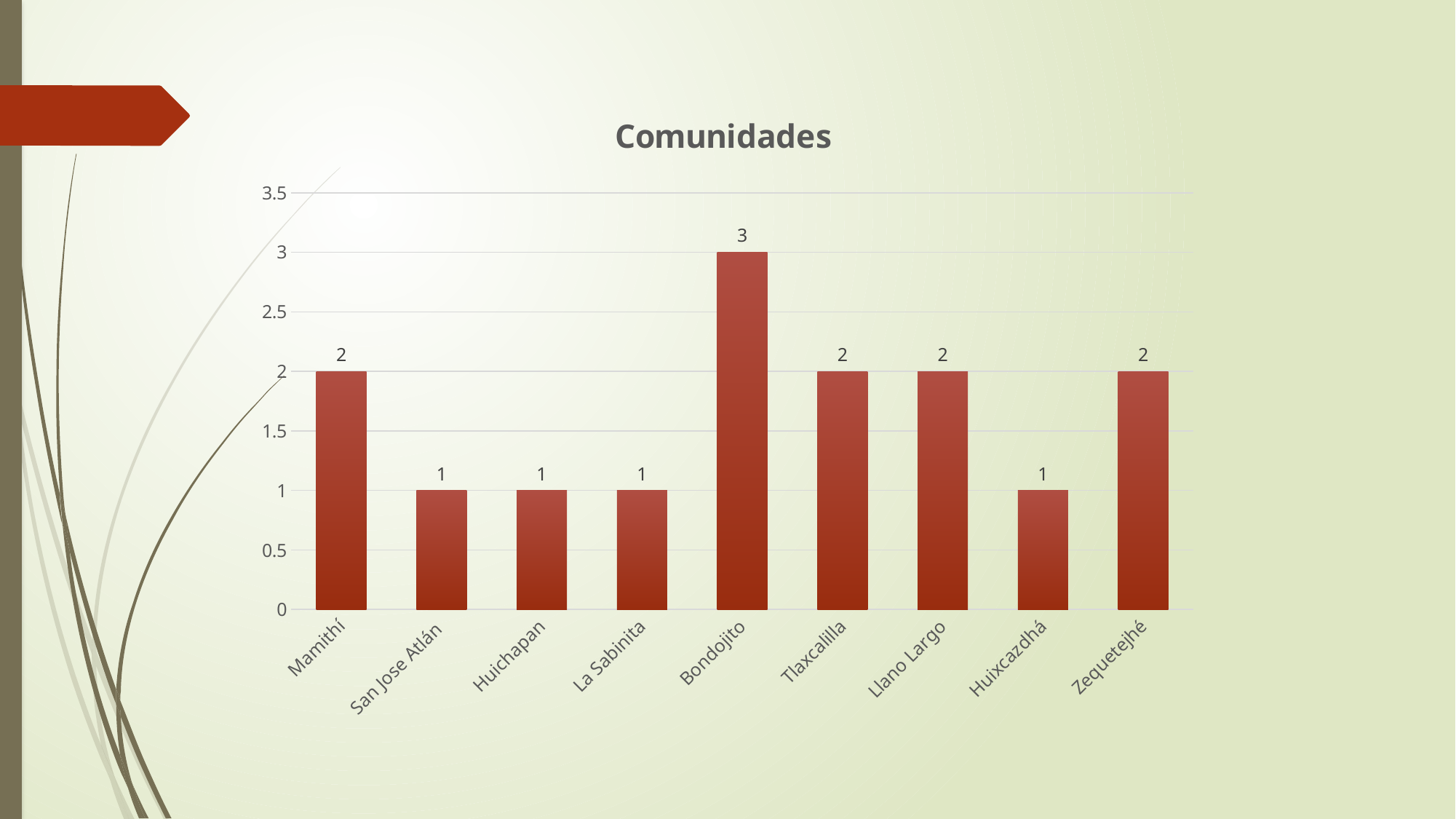
Is the value for Bondojito greater or less than 2.5? greater How many communities have a value of 1? 4 What is the value for Zequetejhé? 2 What is the value for Mamithí? 2 What is the value for Huixcazdhá? 1 Which is larger, the value for Llano Largo or the value for Huichapan? Llano Largo What is the title of the chart? Comunidades What is the value for Bondojito? 3 How many communities are shown on the x axis? 9 What kind of chart is shown on the slide? Bar chart What is the difference between the values for Bondojito and San Jose Atlán? 2 Which community has the highest value? Bondojito